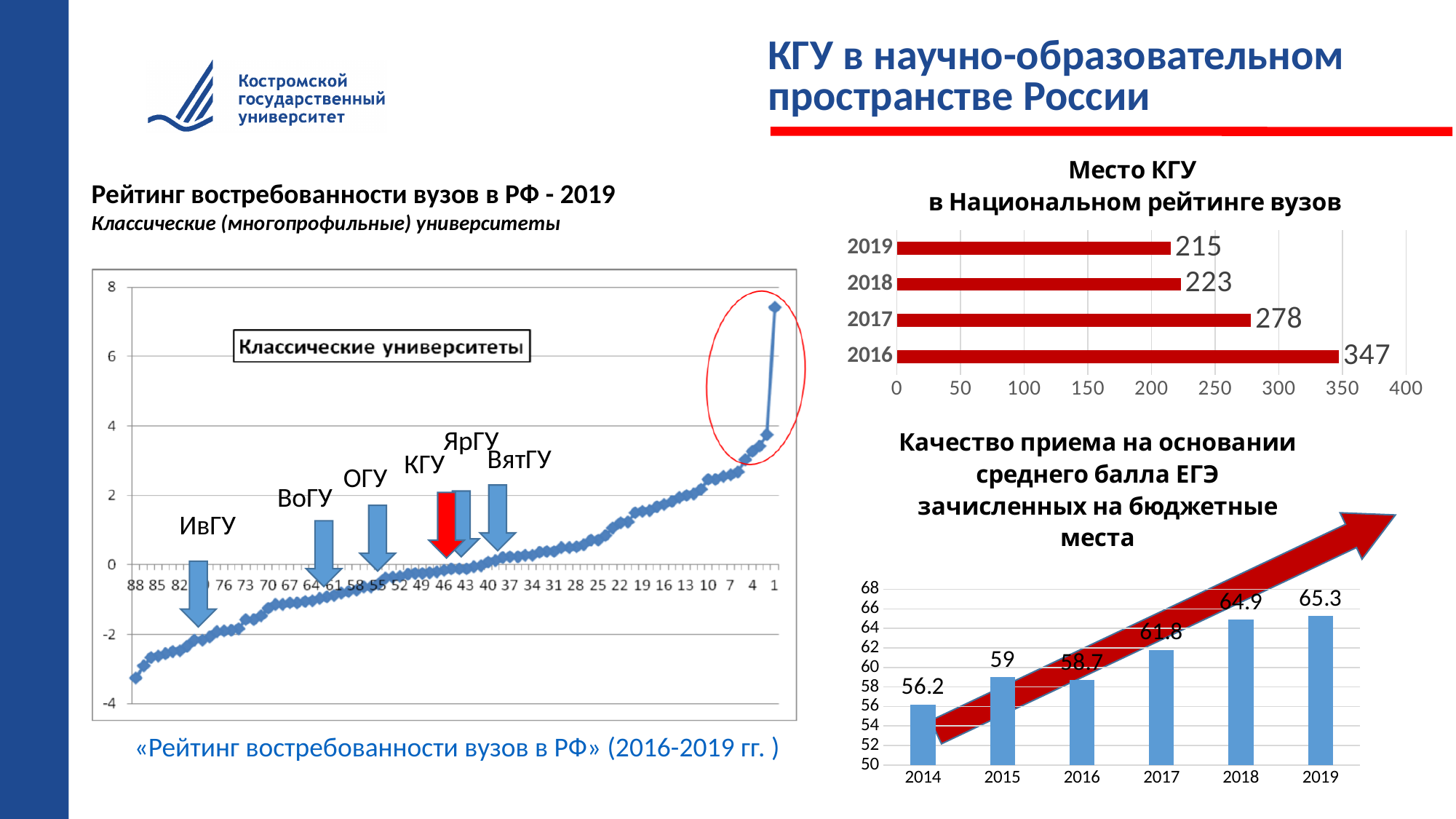
In the chart 'Качество приема на основании среднего балла ЕГЭ', which year has the lowest value? 2014 In the chart 'Качество приема на основании среднего балла ЕГЭ', what is the value for 2018? 64.9 What kind of chart is 'Место КГУ в Национальном рейтинге вузов'? Bar chart In the chart 'Место КГУ в Национальном рейтинге вузов', what is the value for 2019? 215 In the chart 'Качество приема на основании среднего балла ЕГЭ', what is the value for 2014? 56.2 In the chart 'Место КГУ в Национальном рейтинге вузов', which year has the highest value? 2016 In the chart 'Качество приема на основании среднего балла ЕГЭ', what is the difference between the values for 2019 and 2014? 9.1 In the chart 'Место КГУ в Национальном рейтинге вузов', what is the value for 2016? 347 How many years are shown in the chart 'Место КГУ в Национальном рейтинге вузов'? 4 What kind of chart is the left chart titled 'Классические университеты'? Line chart In the chart 'Место КГУ в Национальном рейтинге вузов', what is the difference between the values for 2017 and 2018? 55 In the chart 'Качество приема на основании среднего балла ЕГЭ', which is larger, the value for 2015 or for 2016? 2015